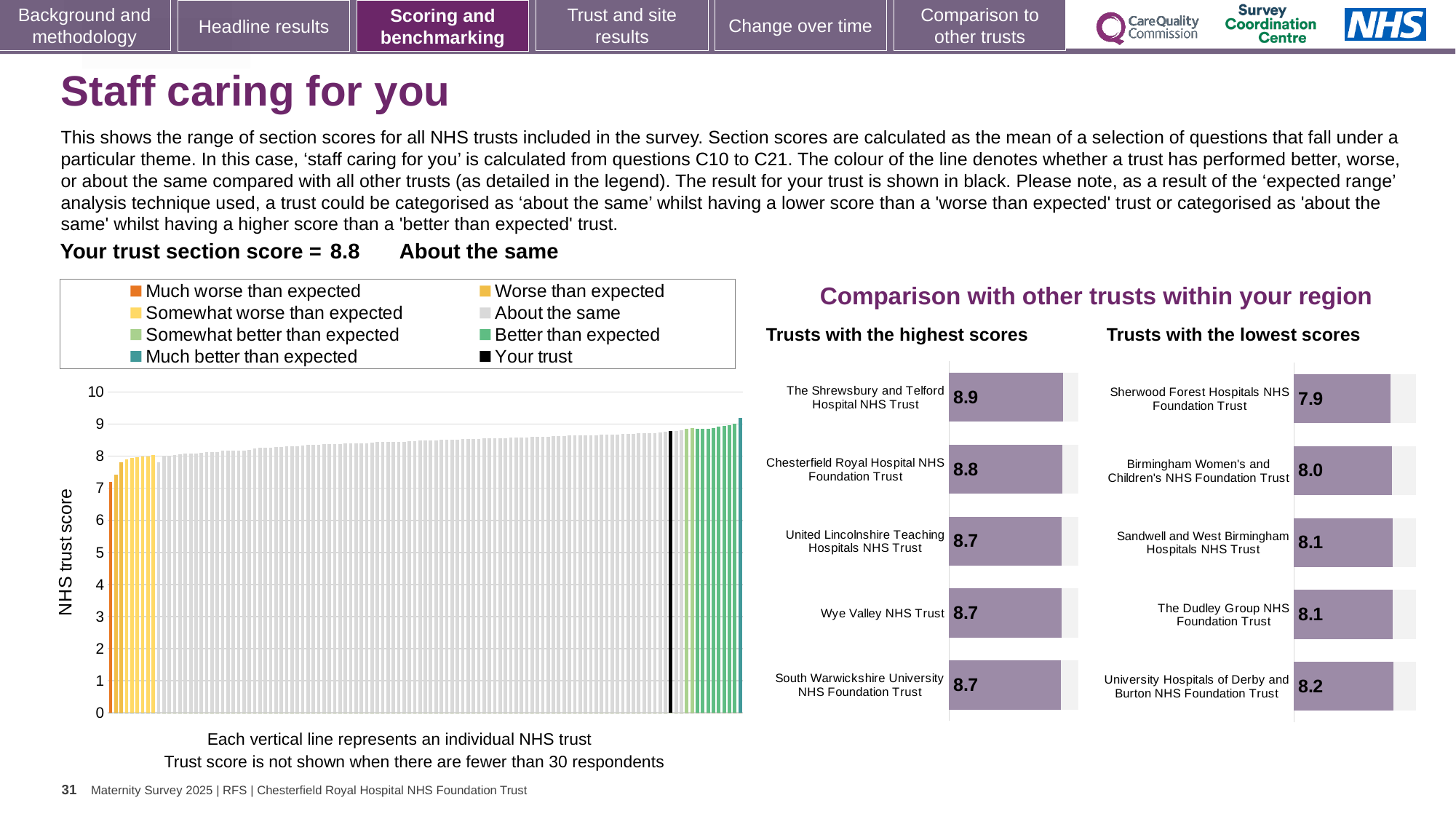
In the 'Trusts with the lowest scores' chart, what is the score for University Hospitals of Derby and Burton NHS Foundation Trust? 8.2 In the 'Trusts with the lowest scores' chart, which has the larger score: Birmingham Women's and Children's NHS Foundation Trust or University Hospitals of Derby and Burton NHS Foundation Trust? University Hospitals of Derby and Burton NHS Foundation Trust In the 'Trusts with the highest scores' chart, which trust has the highest score? The Shrewsbury and Telford Hospital NHS Trust In the 'Trusts with the highest scores' chart, how many trusts are listed? 5 In the 'Trusts with the highest scores' chart, what is the score for The Shrewsbury and Telford Hospital NHS Trust? 8.9 In the 'Trusts with the lowest scores' chart, what is the difference between the scores of University Hospitals of Derby and Burton NHS Foundation Trust and Sherwood Forest Hospitals NHS Foundation Trust? 0.3 In the 'Trusts with the highest scores' chart, what is the difference between the scores of The Shrewsbury and Telford Hospital NHS Trust and Wye Valley NHS Trust? 0.2 In the 'Trusts with the lowest scores' chart, which trust has the lowest score? Sherwood Forest Hospitals NHS Foundation Trust In the 'Trusts with the lowest scores' chart, what is the score for Sherwood Forest Hospitals NHS Foundation Trust? 7.9 In the 'Trusts with the highest scores' chart, what is the score for Chesterfield Royal Hospital NHS Foundation Trust? 8.8 In the large chart on the left, is the value for the lowest (orange) trust bar greater or less than 8? less What kind of chart is the large chart on the left showing NHS trust scores? Bar chart